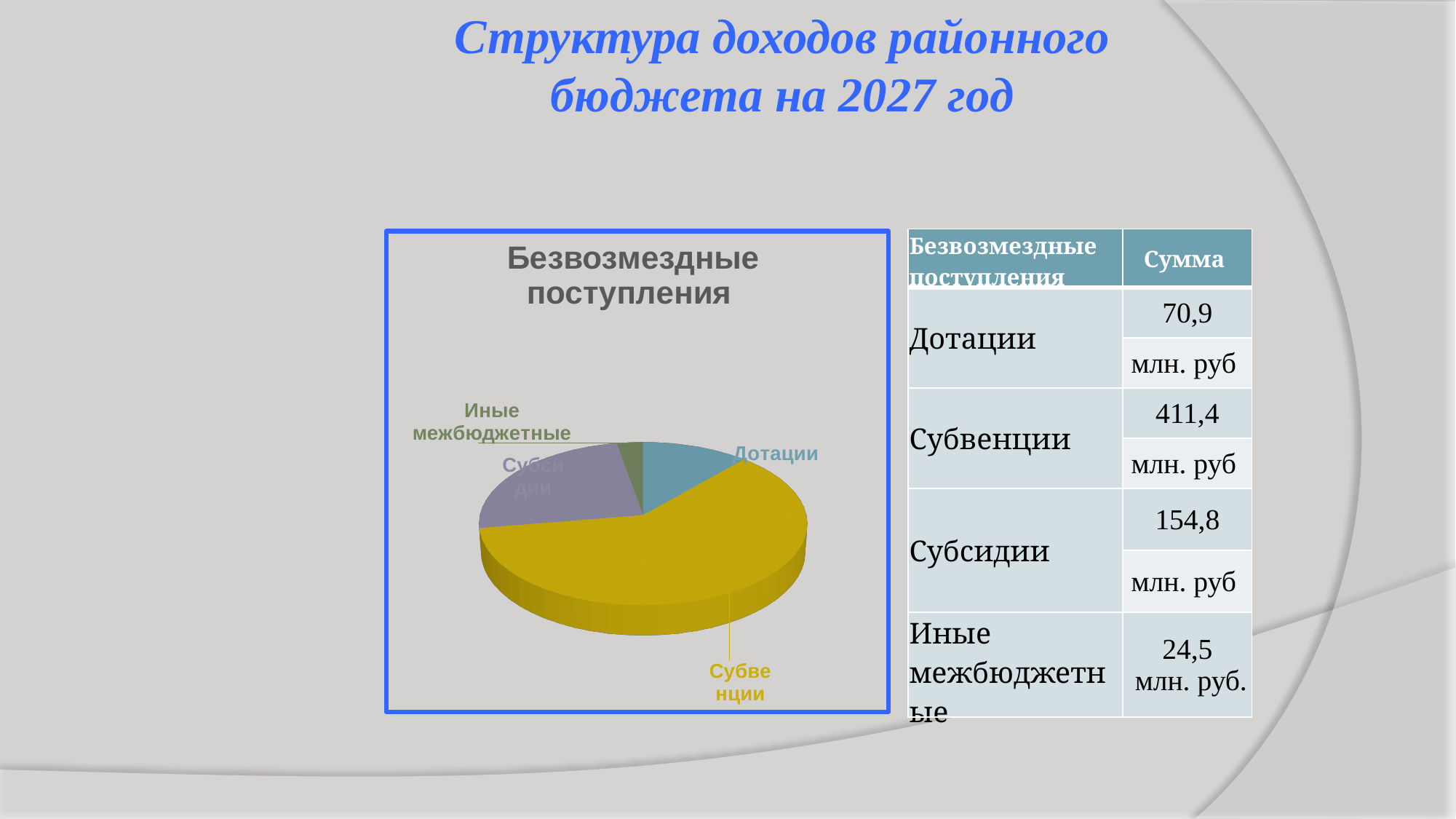
What is the value for Иные межбюджетные according to the table? 24,5 млн. руб. What is the title of the pie chart? Безвозмездные поступления Which category has the largest slice in the pie chart? Субвенции What is the value for Субвенции according to the table? 411,4 млн. руб What is the difference between Субвенции and Дотации? 340,5 млн. руб How many slices does the pie chart have? 4 Which category has the smallest slice in the pie chart? Иные межбюджетные Which is larger, Субсидии or Дотации? Субсидии What is the value for Субсидии according to the table? 154,8 млн. руб What is the value for Дотации according to the table? 70,9 млн. руб What kind of chart is shown on the slide? Pie chart What colour is the Субвенции slice in the pie chart? Yellow